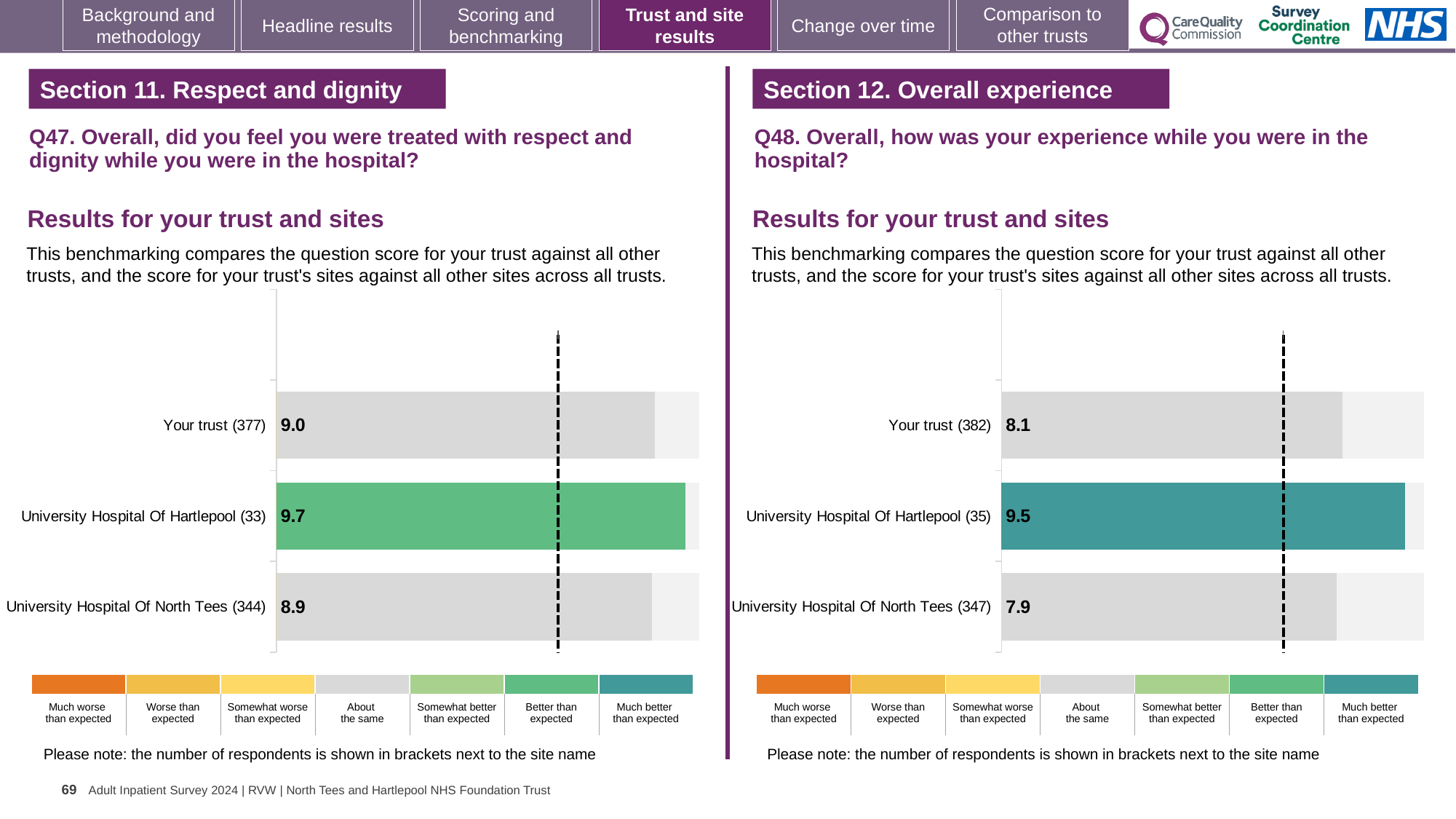
In the Q48 chart on the right, what is the difference between the scores for University Hospital Of Hartlepool and University Hospital Of North Tees? 1.6 In the Q48 chart on the right, how many respondents are shown in brackets for University Hospital Of Hartlepool? 35 In the Q47 chart on the left, what is the difference between the scores for University Hospital Of Hartlepool and Your trust? 0.7 In the Q48 chart on the right, which site or trust has the lowest score? University Hospital Of North Tees In the Q47 chart on the left, what is the score for University Hospital Of Hartlepool? 9.7 In the Q47 chart on the left, which site or trust has the highest score? University Hospital Of Hartlepool What type of chart is used for the Q48 results on the right? Bar chart In the Q47 chart on the left, what is the score for Your trust? 9.0 How many bars are plotted in the Q47 chart on the left? 3 In the Q48 chart on the right, what is the score for Your trust? 8.1 In the Q48 chart on the right, what is the score for University Hospital Of North Tees? 7.9 In the Q48 chart on the right, which has the larger score, Your trust or University Hospital Of Hartlepool? University Hospital Of Hartlepool